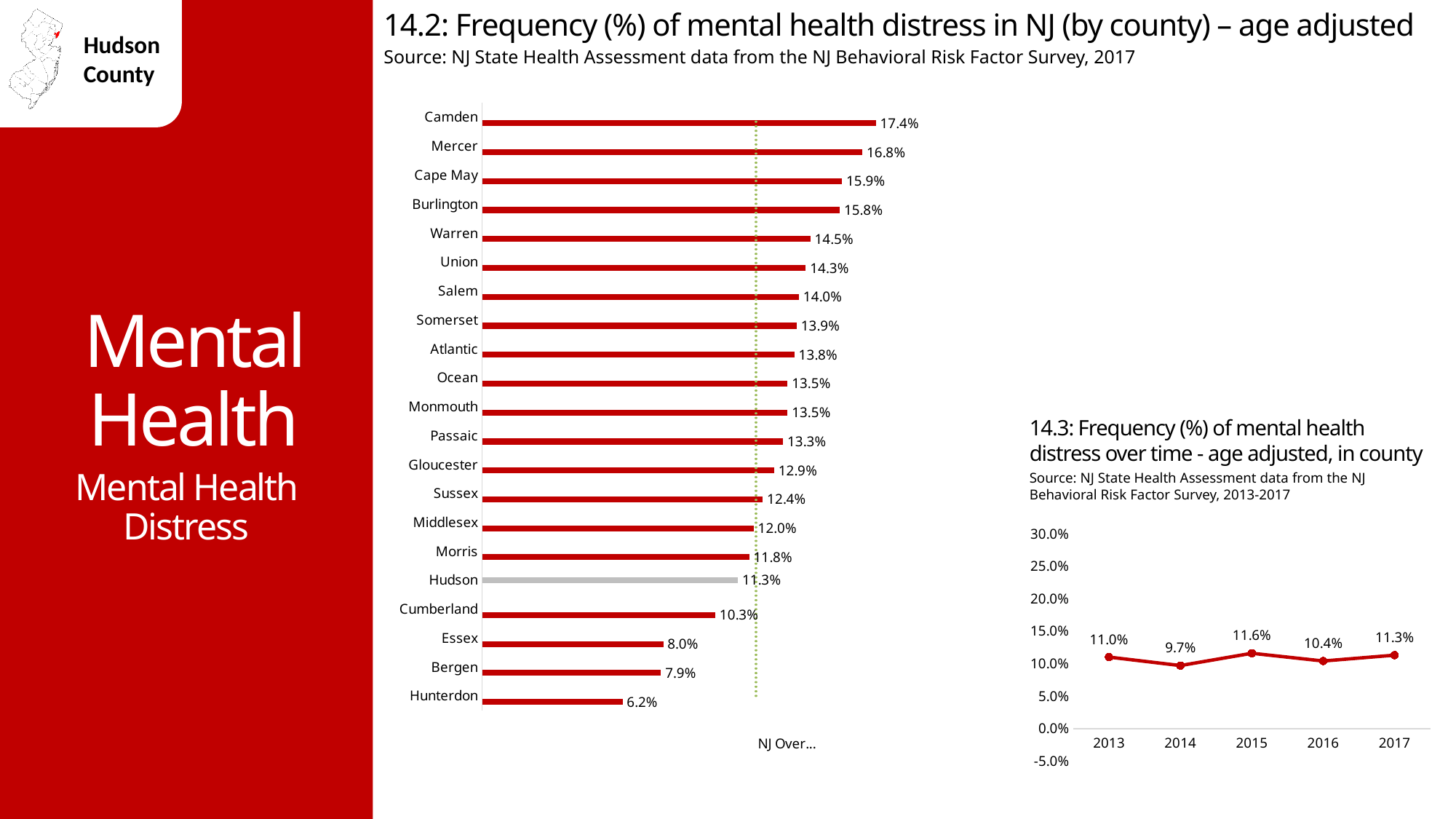
In chart 14.2 (mental health distress by county), what is the value for Hudson? 11.3% In chart 14.2 (mental health distress by county), what is the value for Camden? 17.4% In chart 14.2 (mental health distress by county), what is the difference between Camden and Hudson? 6.1% In chart 14.2 (mental health distress by county), which county has the lowest value? Hunterdon What kind of chart is chart 14.2 (mental health distress by county)? Bar chart In chart 14.3 (mental health distress over time), what is the difference between 2015 and 2014? 1.9% In chart 14.3 (mental health distress over time), what is the value for 2014? 9.7% In chart 14.2 (mental health distress by county), which county has the highest value? Camden In chart 14.3 (mental health distress over time), which year has the highest value? 2015 In chart 14.2 (mental health distress by county), which is larger, the value for Essex or the value for Bergen? Essex What kind of chart is chart 14.3 (mental health distress over time)? Line chart In chart 14.2 (mental health distress by county), how many counties are shown? 21